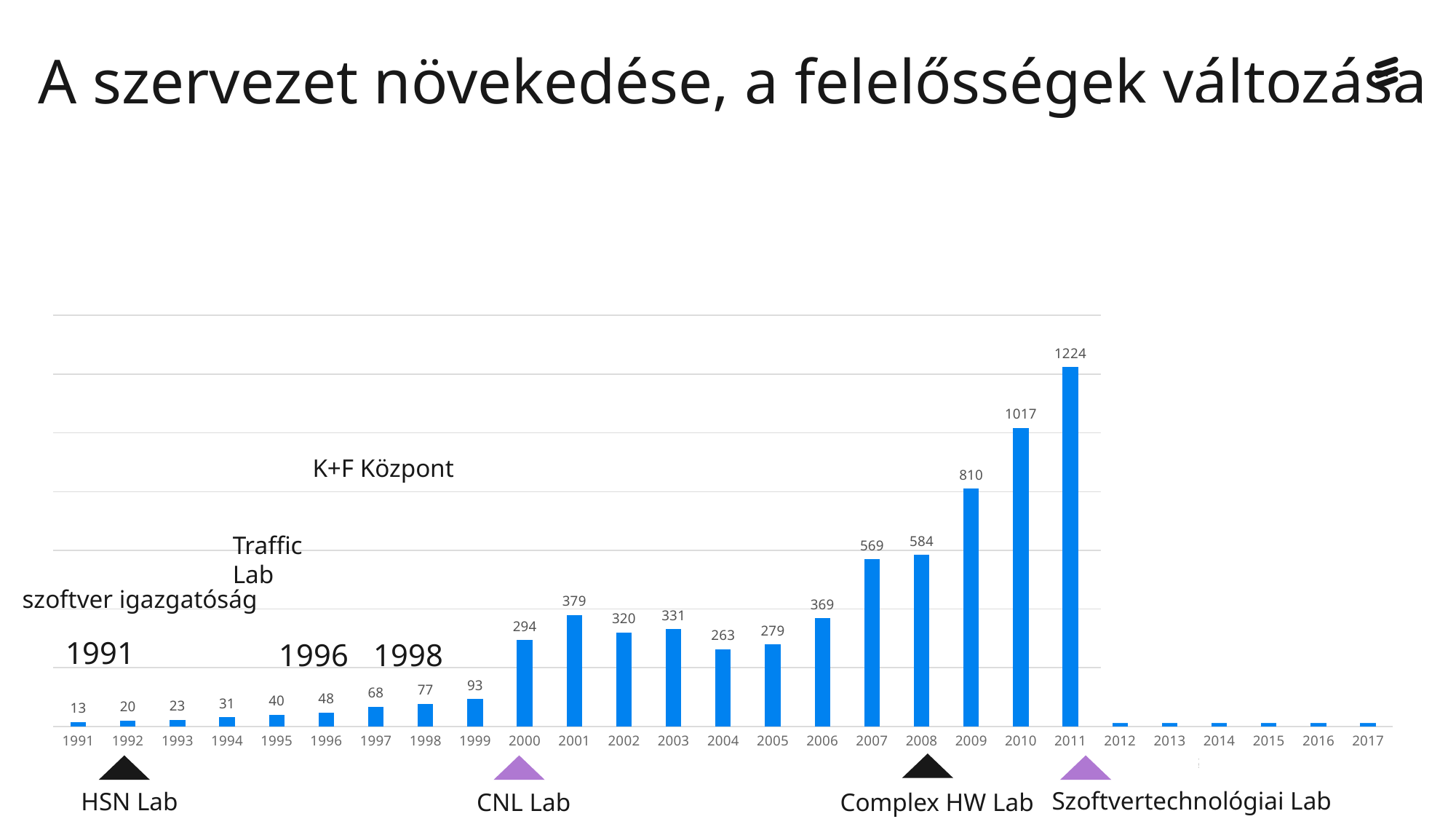
What is the value for 2000? 294 What is the difference between the values for 2011 and 2010? 207 Which is larger, the value for 2002 or the value for 2003? 2003 Do the values rise or fall from 1991 to 1999? rise Which year has the highest value? 2011 What is the difference between the values for 2001 and 2000? 85 How many years are shown on the x axis? 27 What is the value for 2011? 1224 What is the value for 1995? 40 What is the title of the slide? A szervezet növekedése, a felelősségek változása What type of chart is shown on the slide? bar chart What is the value for 2004? 263